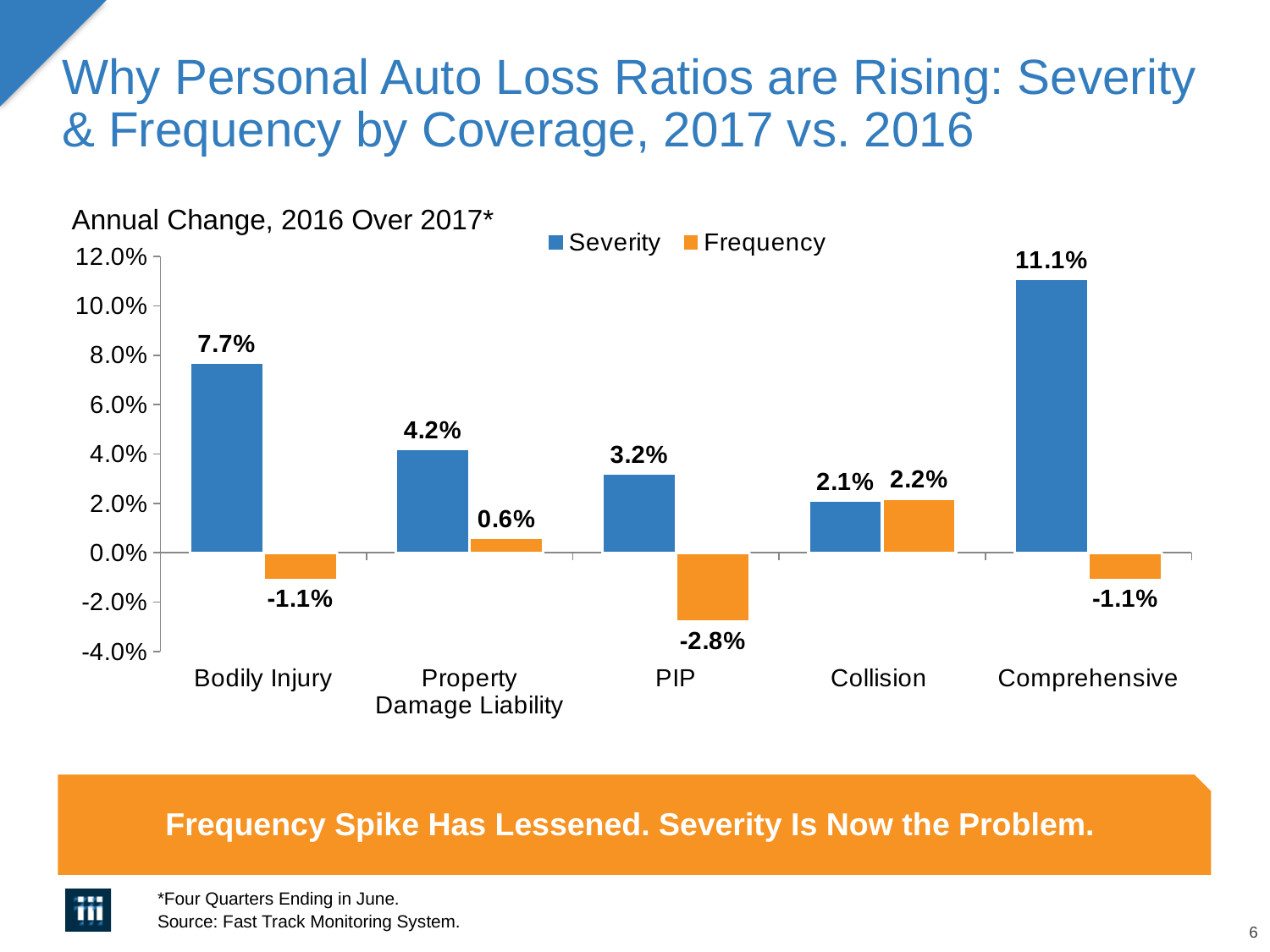
How many series does the legend list? 2 What is the Severity value for Property Damage Liability? 4.2% Which coverage has the lowest Frequency value? PIP What is the difference between the Severity values for Bodily Injury and PIP? 4.5% Which coverage has the highest Severity value? Comprehensive What colour are the Frequency bars? Orange What is the Severity value for Comprehensive? 11.1% Which is larger for Collision, the Severity value or the Frequency value? Frequency What is the Frequency value for PIP? -2.8% What is the Frequency value for Collision? 2.2% What kind of chart is shown on the slide? Bar chart How many coverage categories are shown on the x axis? 5